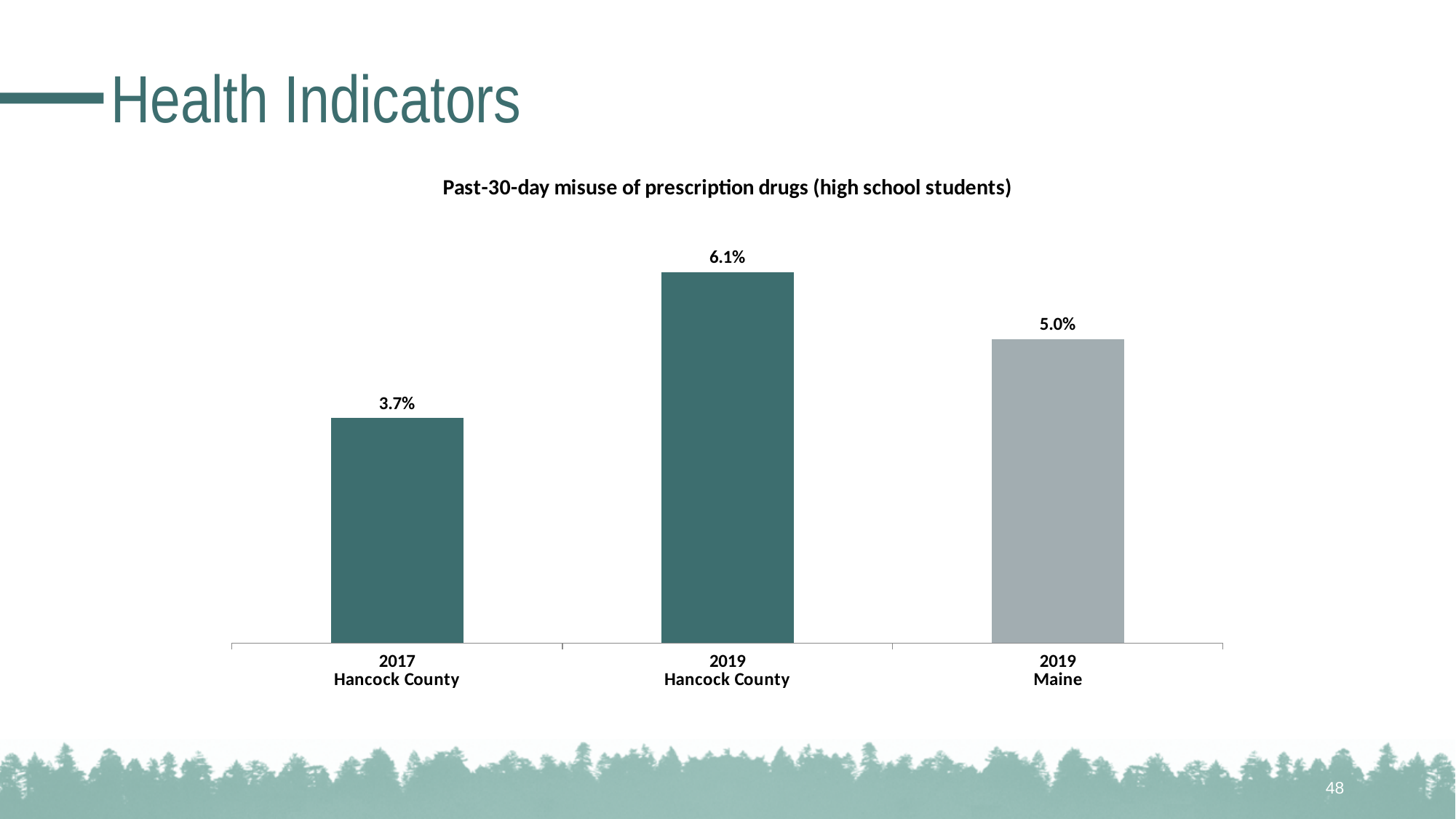
What is the value for 2019 Hancock County? 6.1% Which category has the lowest value? 2017 Hancock County How many bars are shown in the chart? 3 What is the title of the chart? Past-30-day misuse of prescription drugs (high school students) What is the value for 2017 Hancock County? 3.7% What kind of chart is shown on the slide? Bar chart Which category has the highest value? 2019 Hancock County Did the Hancock County value rise or fall from 2017 to 2019? Rise What is the difference between the 2019 Hancock County value and the 2017 Hancock County value? 2.4% What is the value for 2019 Maine? 5.0% Which is larger, the value for 2019 Hancock County or the value for 2019 Maine? 2019 Hancock County What is the difference between the 2019 Hancock County value and the 2019 Maine value? 1.1%